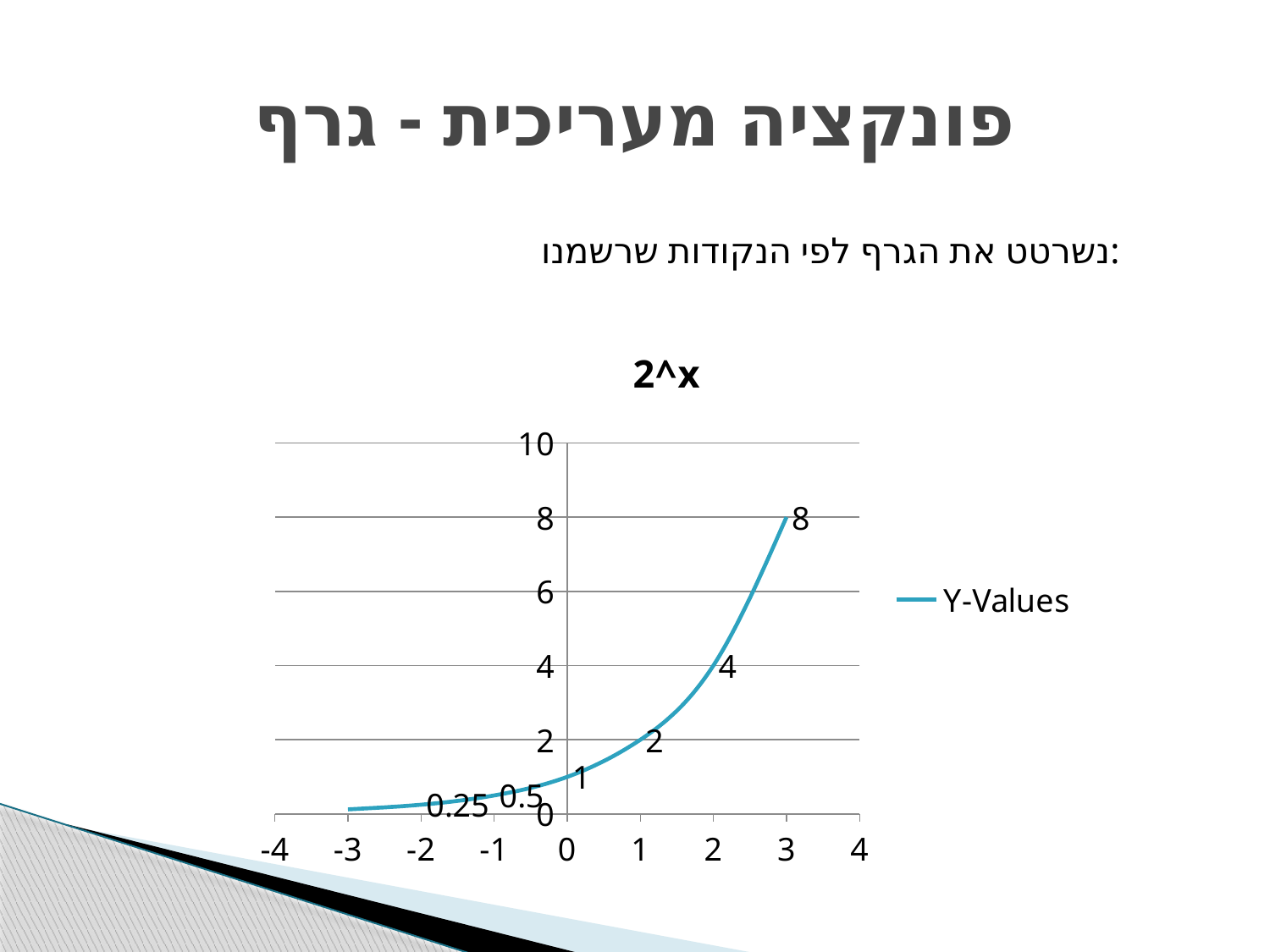
Do the values rise or fall as x increases along the x axis? rise How many series does the legend list? 1 What is the value of Y-Values at x = 0? 1 What is the value of Y-Values at x = 2? 4 What is the difference between the value at x = 3 and the value at x = 2? 4 What is the name of the series shown in the legend? Y-Values What is the value of Y-Values at x = 1? 2 What is the value of Y-Values at x = 3? 8 What is the value of Y-Values at x = -1? 0.5 What is the title of the chart? 2^x What is the value of Y-Values at x = -2? 0.25 What kind of chart is shown on the slide? line chart